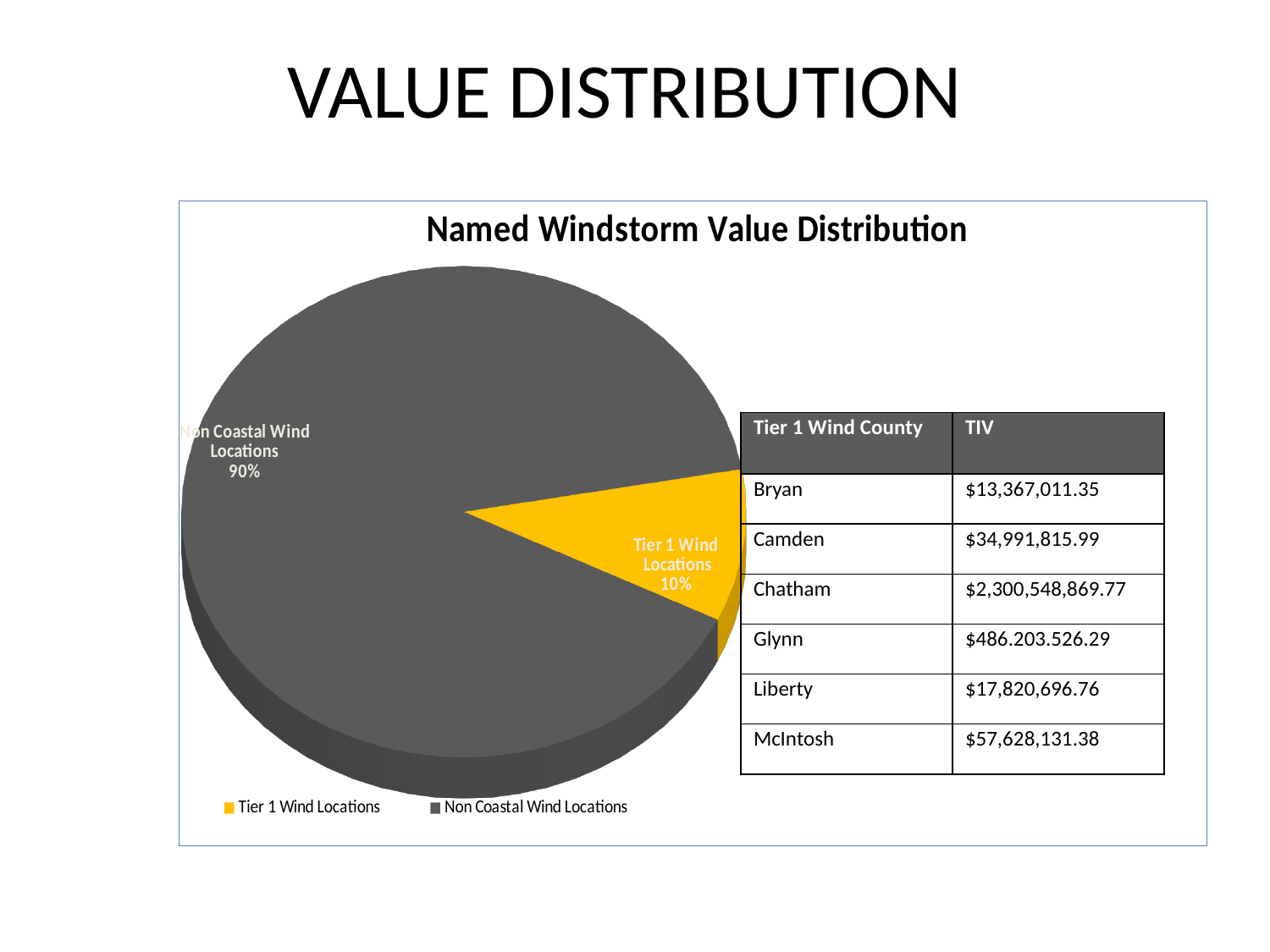
What kind of chart is shown under the title "Named Windstorm Value Distribution"? Pie chart Which slice of the pie chart is the smallest? Tier 1 Wind Locations Which slice of the pie chart is the largest? Non Coastal Wind Locations How many entries does the pie chart's legend list? 2 How many slices does the pie chart have? 2 What share of the pie is Non Coastal Wind Locations? 90% What is the difference in percentage points between the Non Coastal Wind Locations slice and the Tier 1 Wind Locations slice? 80 percentage points Which is larger in the pie chart, Tier 1 Wind Locations or Non Coastal Wind Locations? Non Coastal Wind Locations What colour is the Tier 1 Wind Locations slice in the pie chart? Yellow What is the title of the pie chart? Named Windstorm Value Distribution What share of the pie is Tier 1 Wind Locations? 10%